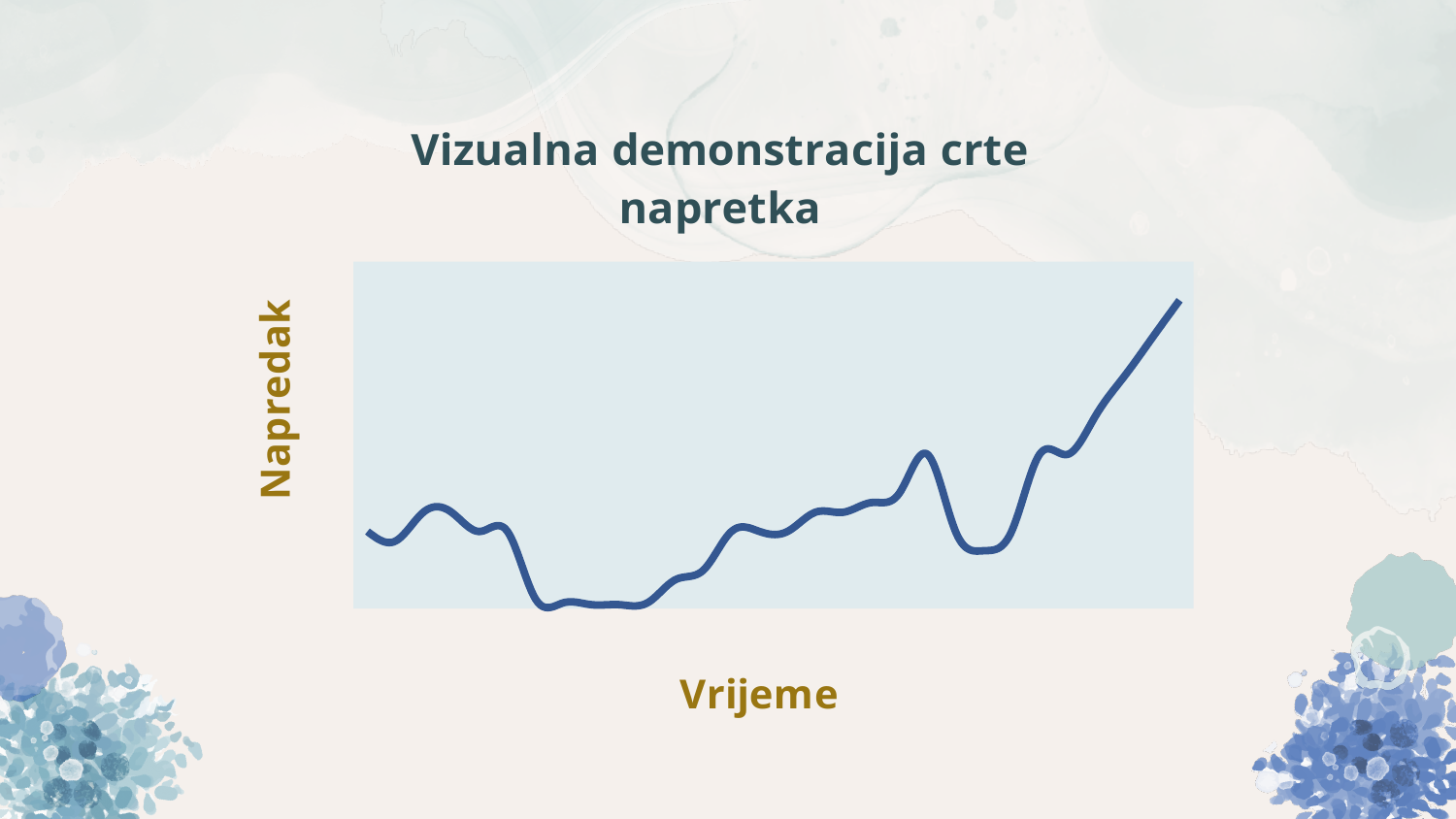
How many lines are plotted on the chart? 1 What labels are shown on the y axis and the x axis of the chart? Napredak (y axis) and Vrijeme (x axis) Overall, does the line rise or fall from left to right along the x axis? rise Which is higher, the value at the left end of the line or the value at the right end? the right end What kind of chart is shown on the slide? line chart What is the title of the chart on the slide? Vizualna demonstracija crte napretka